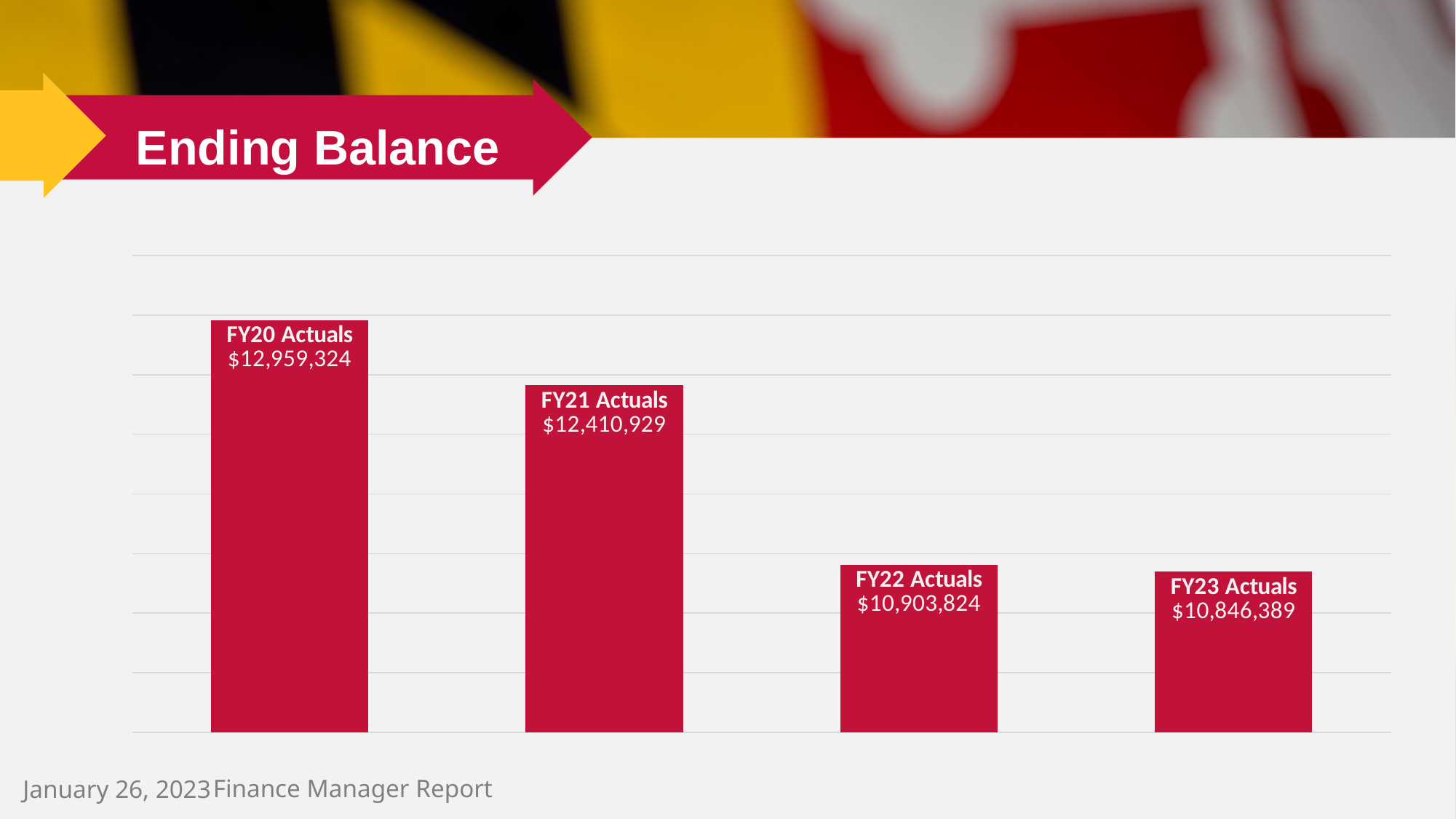
What is the value for FY20 Actuals? $12,959,324 How many categories are shown in the chart? 4 Which category has the lowest ending balance? FY23 Actuals Which is larger, FY21 Actuals or FY22 Actuals? FY21 Actuals What kind of chart is shown on the slide? Bar chart What is the difference between FY20 Actuals and FY21 Actuals? $548,395 What is the value for FY22 Actuals? $10,903,824 What is the value for FY23 Actuals? $10,846,389 Do the values rise or fall from FY20 Actuals to FY23 Actuals? Fall What is the value for FY21 Actuals? $12,410,929 What is the difference between FY22 Actuals and FY23 Actuals? $57,435 Which category has the highest ending balance? FY20 Actuals